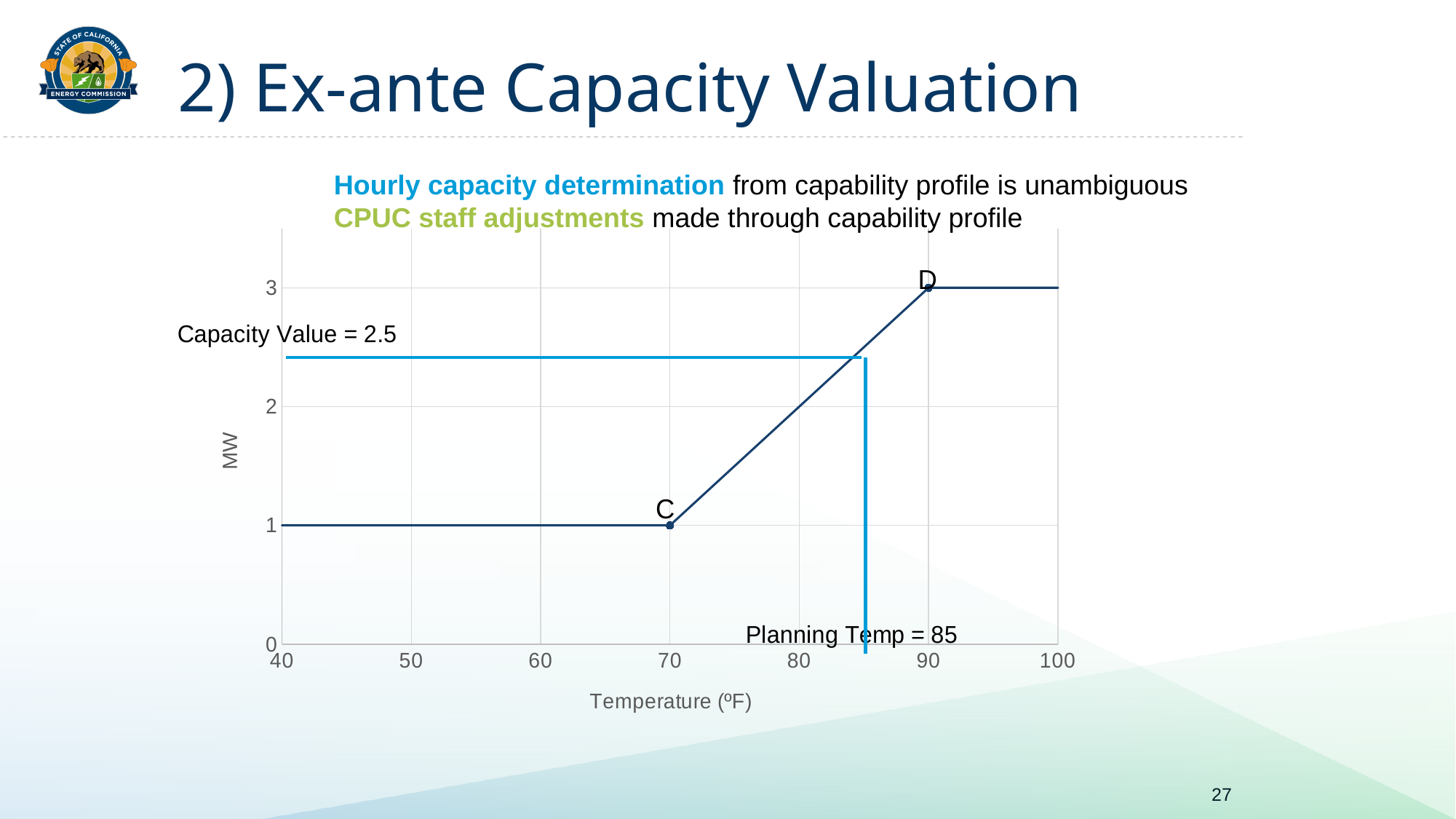
Is the MW value at 80 ºF greater or less than 1? greater What is the label of the x axis? Temperature (ºF) Does the MW value rise or fall as temperature increases from 70 to 90 ºF? rise At what temperature (ºF) is point C located? 70 What is the MW value at point C? 1 What is the MW value at point D? 3 What is the difference in MW between point D and point C? 2 What is the Planning Temp shown on the chart? 85 What is the Capacity Value shown on the chart? 2.5 Which point has the higher MW value, C or D? D At what temperature (ºF) is point D located? 90 What kind of chart is shown on the slide? line chart